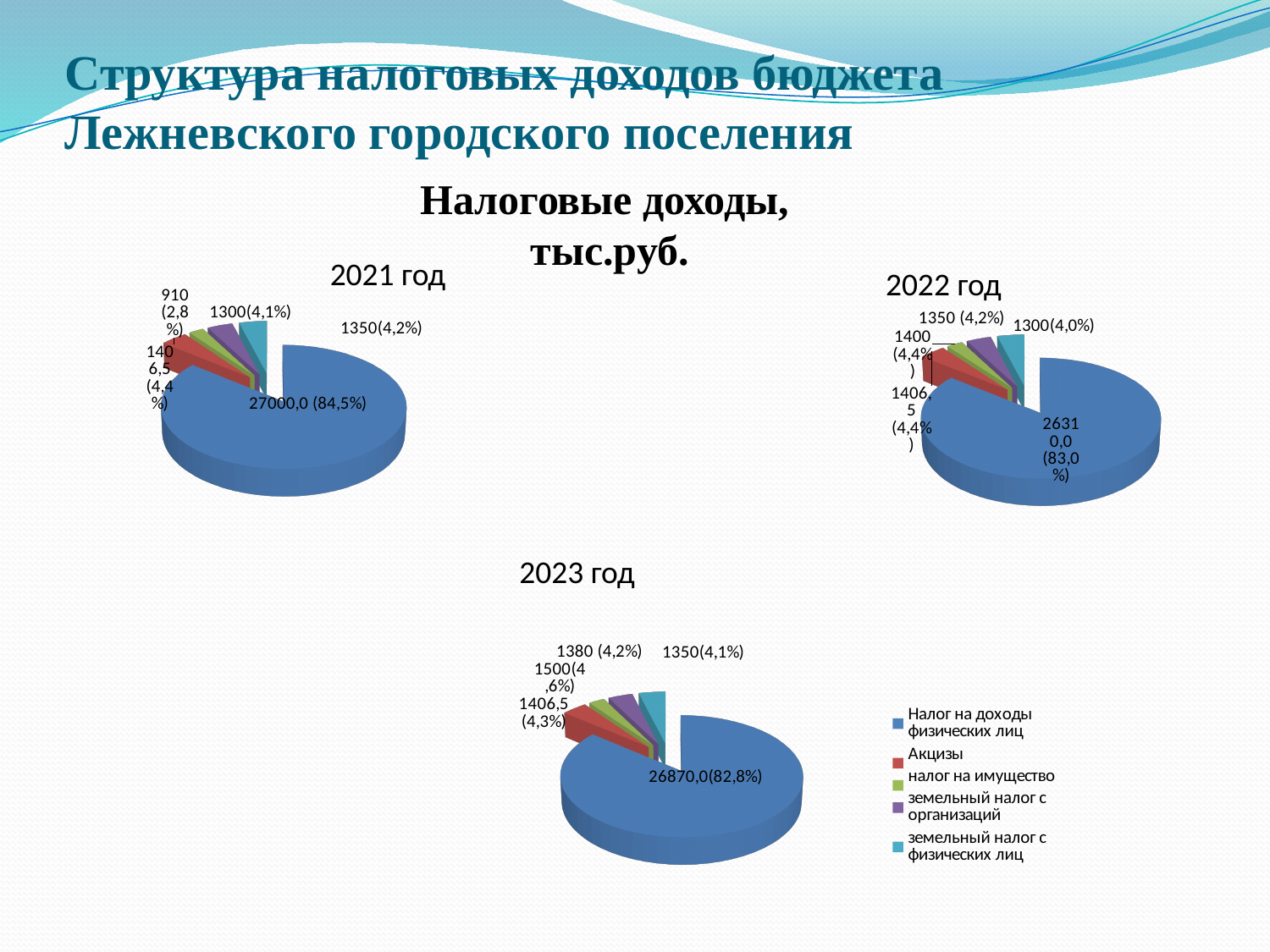
Which is larger: the Налог на доходы физических лиц value in 2021 год or in 2022 год? 2021 год In the 2021 год chart, which slice is the smallest? 910 (2,8%) How many entries does the legend list? 5 Which category is the largest in the 2023 год chart? Налог на доходы физических лиц In the 2023 год chart, what is the value labelled on the largest slice? 26870,0(82,8%) In the 2021 год chart, what is the value shown for the largest slice (Налог на доходы физических лиц)? 27000,0 (84,5%) What is the title shown above the charts? Налоговые доходы, тыс.руб. How many slices does the 2022 год pie chart have? 5 What is the difference between the Налог на доходы физических лиц value in 2021 год (27000,0) and in 2022 год (26310,0)? 690,0 What type of chart is used for the 2021 год chart? pie chart In the 2022 год chart, what share of the pie does Налог на доходы физических лиц take? 83,0% Which legend entry is shown in red? Акцизы